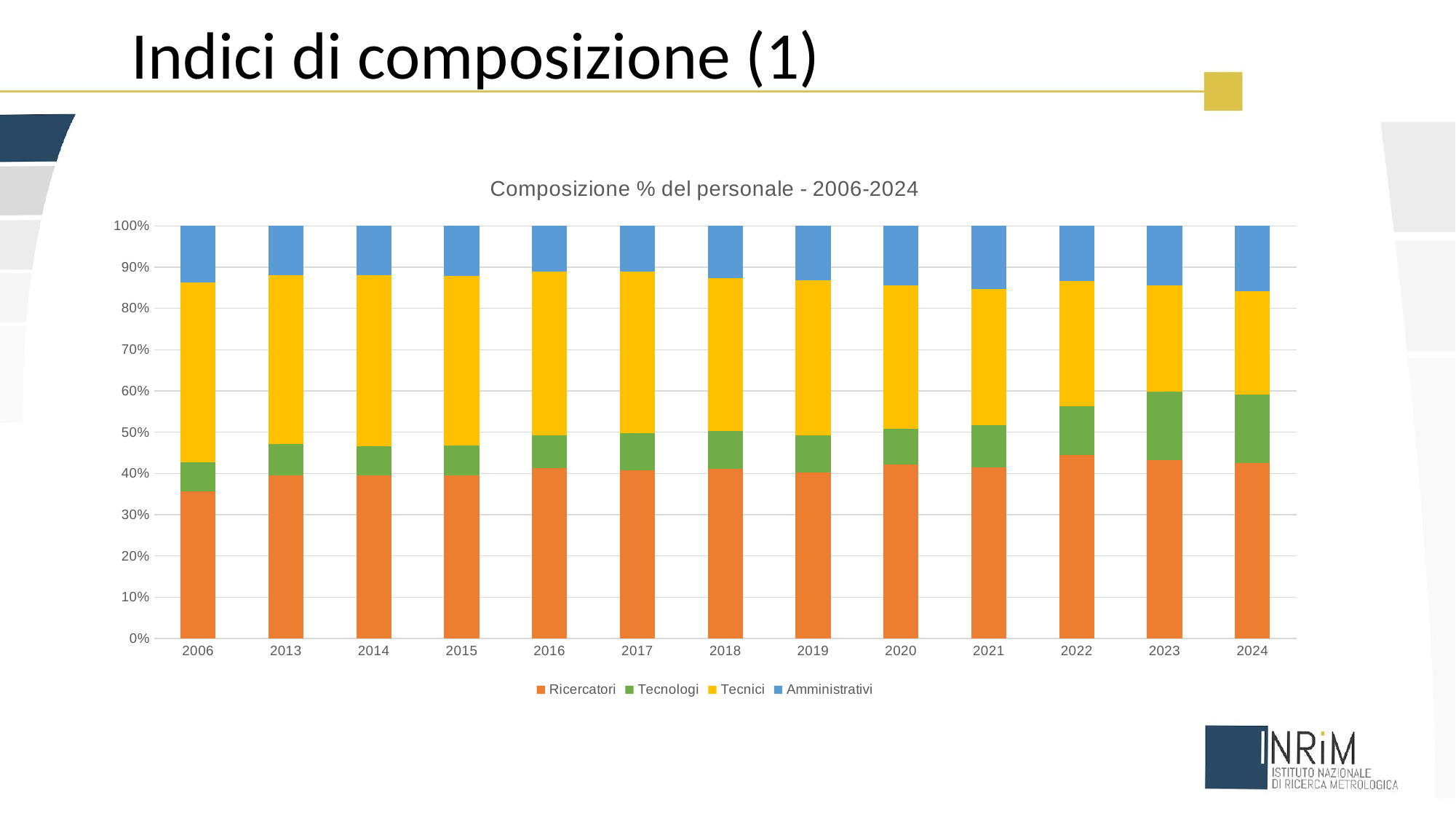
Which series is shown in orange? Ricercatori Does the Tecnologi share generally rise or fall from 2006 to 2024? rise Is the Ricercatori share for 2006 greater or less than 40%? less Which is larger, the Ricercatori share in 2006 or in 2022? 2022 How many years are shown on the x axis? 13 What is the title of the chart? Composizione % del personale - 2006-2024 Is the Ricercatori share for 2006 greater or less than 30%? greater Which year has the lowest Ricercatori share? 2006 How many series does the legend list? 4 Which is larger, the Tecnologi share in 2006 or in 2024? 2024 What kind of chart is shown on the slide? stacked bar chart Is the Ricercatori share for 2022 greater or less than 40%? greater